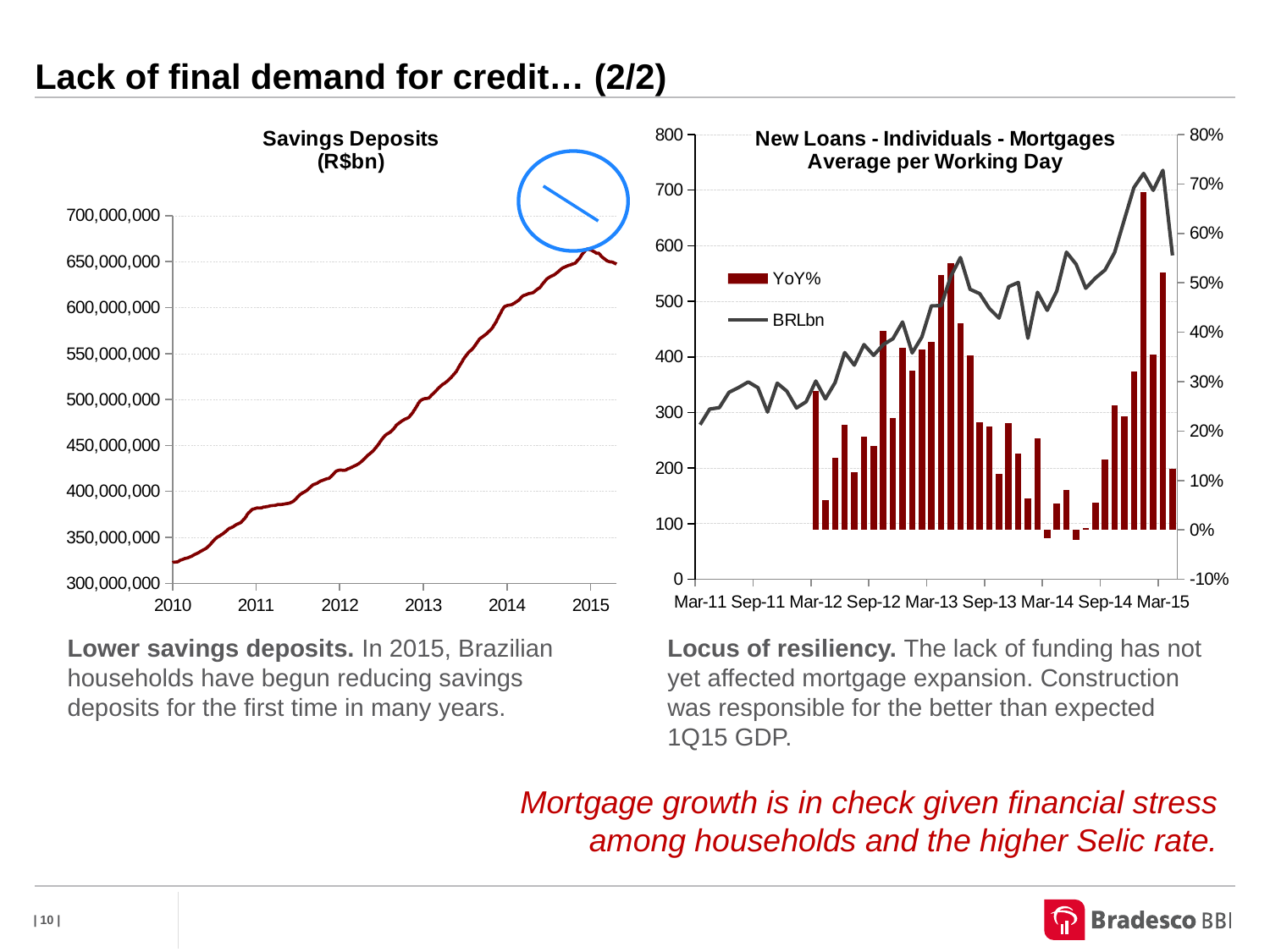
In the New Loans - Individuals - Mortgages chart, is the BRLbn value at Mar-11 greater or less than 400? Less How many year labels appear on the x axis of the Savings Deposits chart? 6 In the Savings Deposits chart, do the values rise or fall from 2010 to 2014? Rise In the Savings Deposits chart, is the value at the start of 2010 greater or less than 350,000,000? Less What kind of chart is the Savings Deposits chart on the left? Line chart How many series does the legend of the New Loans - Individuals - Mortgages chart list? 2 In the New Loans - Individuals - Mortgages chart, which series is drawn as a line? BRLbn In the New Loans - Individuals - Mortgages chart, is the highest BRLbn value near Mar-15 greater or less than 700? Greater In the New Loans - Individuals - Mortgages chart, which series is drawn as bars? YoY% What is the maximum value shown on the left axis of the New Loans - Individuals - Mortgages chart? 800